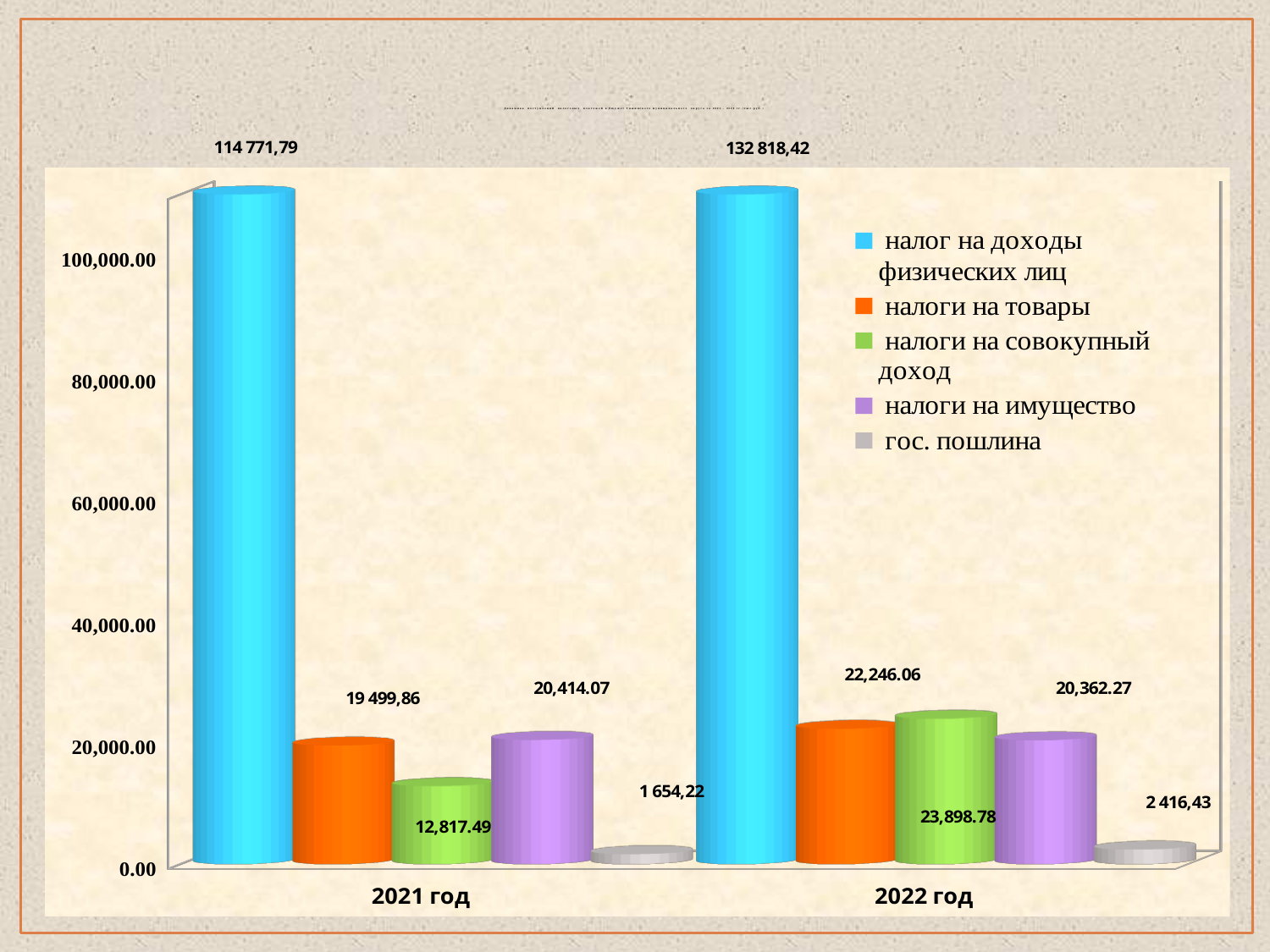
What is the value for налог на доходы физических лиц in 2022 год? 132 818,42 Which series has the highest value in 2022 год? налог на доходы физических лиц What is the value for налоги на совокупный доход in 2022 год? 23,898.78 What is the value for налог на доходы физических лиц in 2021 год? 114 771,79 Which series has the lowest value in 2021 год? гос. пошлина Which is larger: налоги на товары in 2021 год or налоги на товары in 2022 год? налоги на товары in 2022 год What is the value for гос. пошлина in 2021 год? 1 654,22 Is the value for налог на доходы физических лиц in 2021 год greater or less than 100,000.00? greater What is the difference between the values for налоги на имущество in 2021 год and 2022 год? 51.80 How many categories (years) are shown on the x axis? 2 What kind of chart is shown on the slide? bar chart How many series does the legend list? 5